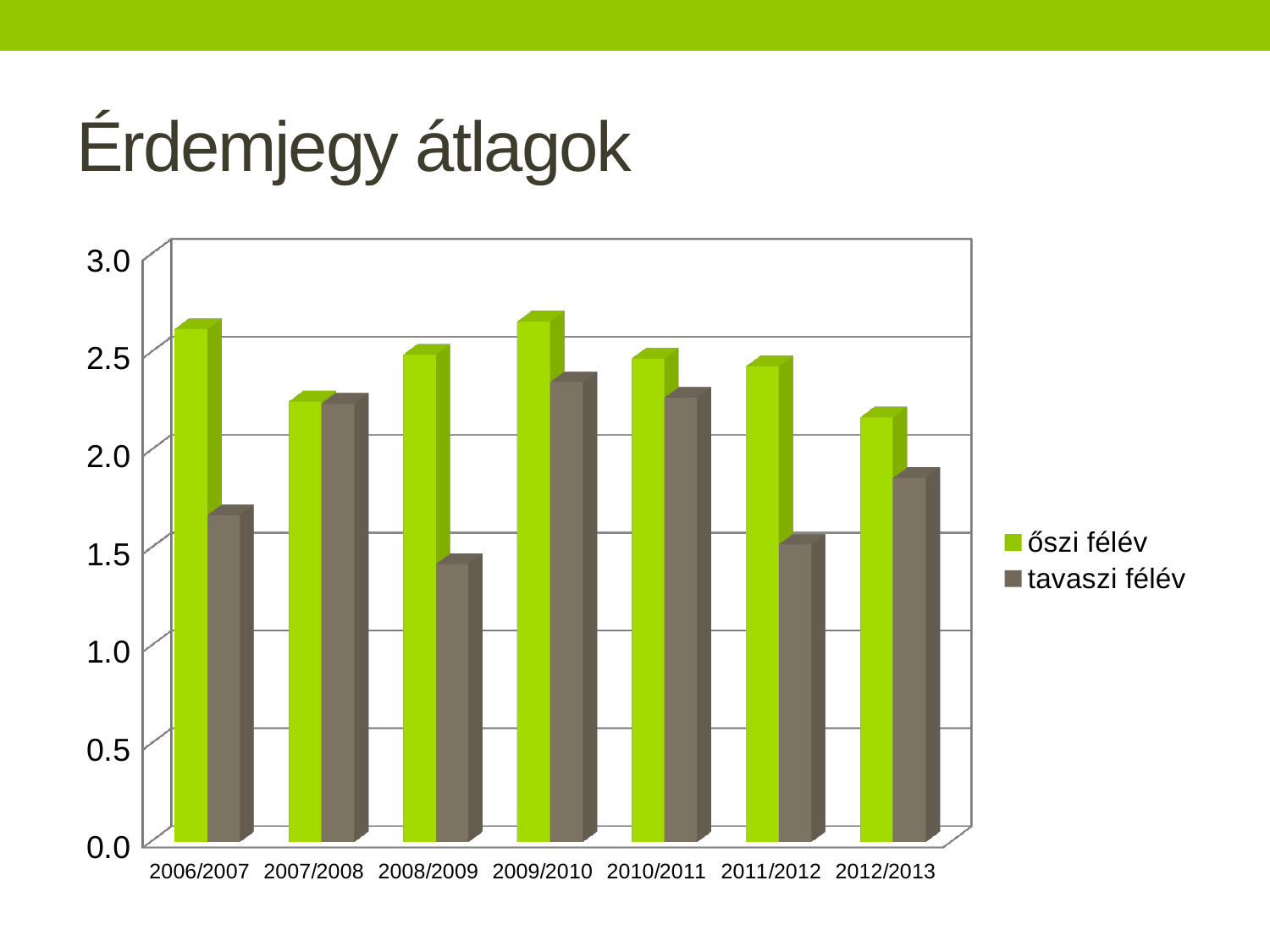
What is the title of the slide? Érdemjegy átlagok How many series does the legend list? 2 Is the value for tavaszi félév in 2012/2013 greater or less than 2.0? less In 2008/2009, which is larger: őszi félév or tavaszi félév? őszi félév Is the value for tavaszi félév in 2008/2009 greater or less than 1.5? less Is the value for tavaszi félév in 2006/2007 greater or less than 1.5? greater What kind of chart is shown on the slide? bar chart In 2006/2007, which is larger: őszi félév or tavaszi félév? őszi félév How many academic years are shown on the x axis? 7 Which series is shown in green? őszi félév